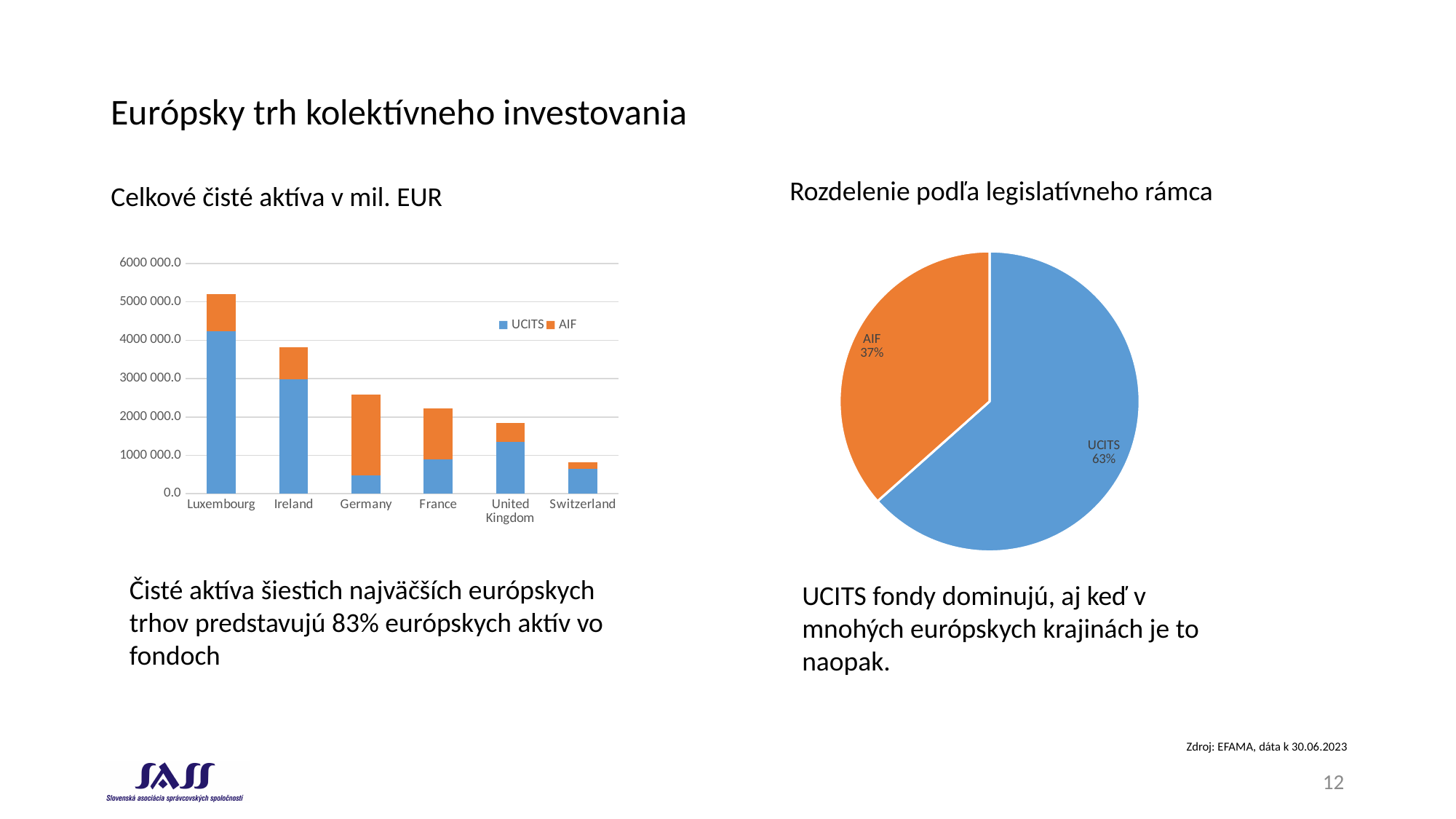
On the 'Celkové čisté aktíva v mil. EUR' chart, is the total value for Luxembourg greater or less than 4000 000.0? greater On the 'Rozdelenie podľa legislatívneho rámca' pie chart, what is the difference in percentage points between the UCITS and AIF slices? 26 On the 'Celkové čisté aktíva v mil. EUR' chart, how many series does the legend list? 2 On the 'Celkové čisté aktíva v mil. EUR' chart, is the total value for Germany greater or less than 2000 000.0? greater On the 'Rozdelenie podľa legislatívneho rámca' pie chart, what share does UCITS have? 63% On the 'Celkové čisté aktíva v mil. EUR' chart, which is larger for Germany, the UCITS portion or the AIF portion? AIF On the 'Celkové čisté aktíva v mil. EUR' chart, is the total value for Switzerland greater or less than 1000 000.0? less On the 'Celkové čisté aktíva v mil. EUR' chart, which country has the lowest total bar? Switzerland On the 'Celkové čisté aktíva v mil. EUR' chart, which country has the highest total bar? Luxembourg On the 'Celkové čisté aktíva v mil. EUR' chart, what kind of chart is shown? stacked bar chart On the 'Celkové čisté aktíva v mil. EUR' chart, how many countries are shown on the x axis? 6 On the 'Celkové čisté aktíva v mil. EUR' chart, do the total bar values rise or fall from Luxembourg to Switzerland? fall